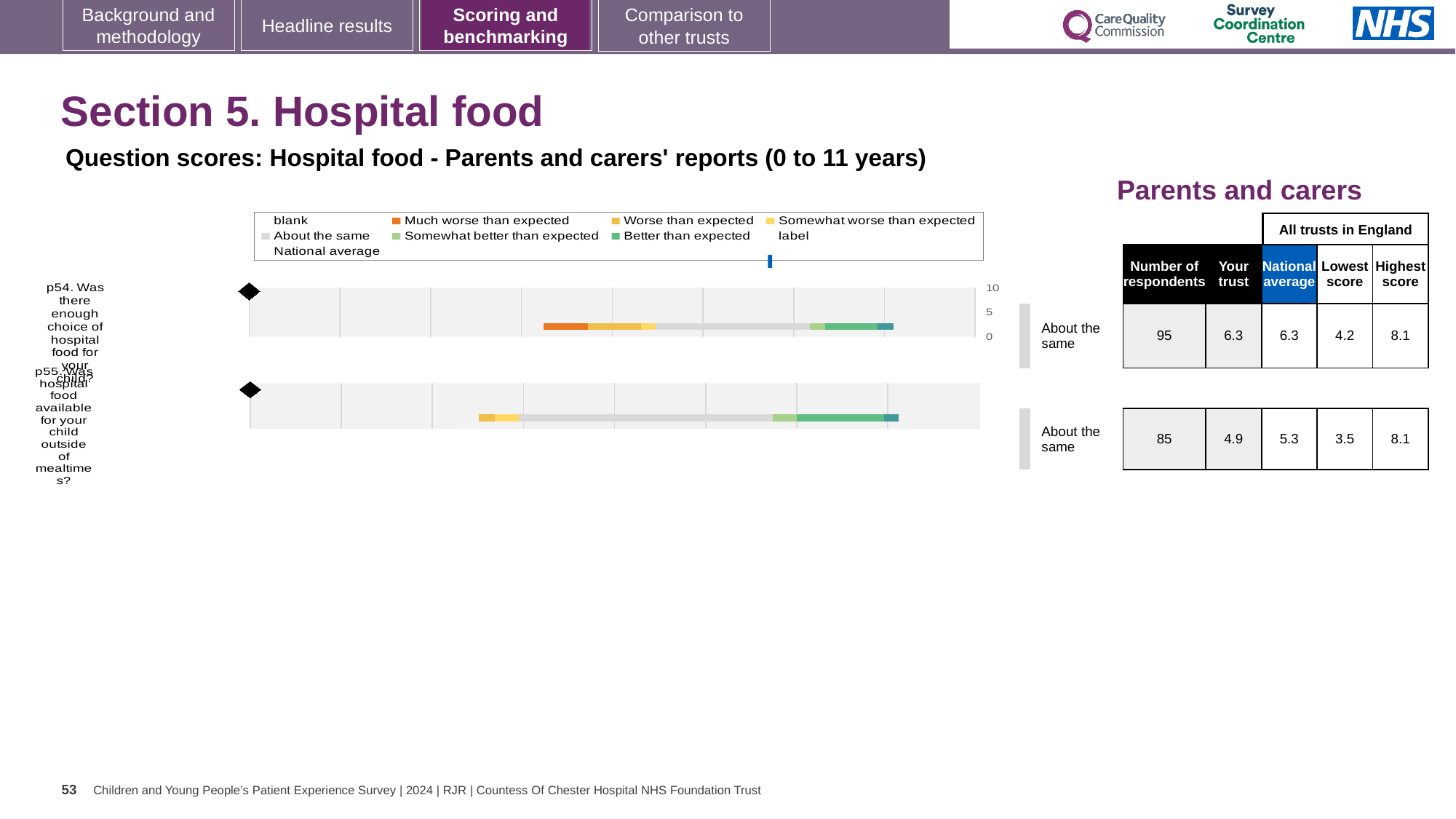
What is the 'Your trust' score for p54 (Was there enough choice of hospital food for your child?)? 6.3 Which question has the lower number of respondents, p54 or p55? p55 How many entries does the legend of the hospital food chart list? 9 What kind of chart is used to show the question scores for hospital food? bar chart How many respondents answered p54? 95 What is the 'Your trust' score for p55 (Was hospital food available for your child outside of mealtimes?)? 4.9 What is the lowest score among all trusts in England for p55? 3.5 Which question has the higher 'Your trust' score, p54 or p55? p54 What benchmark category is shown for both p54 and p55? About the same What is the difference between the 'Your trust' scores for p54 and p55? 1.4 How many questions (categories) are plotted in the hospital food chart? 2 What is the national average score for p55? 5.3